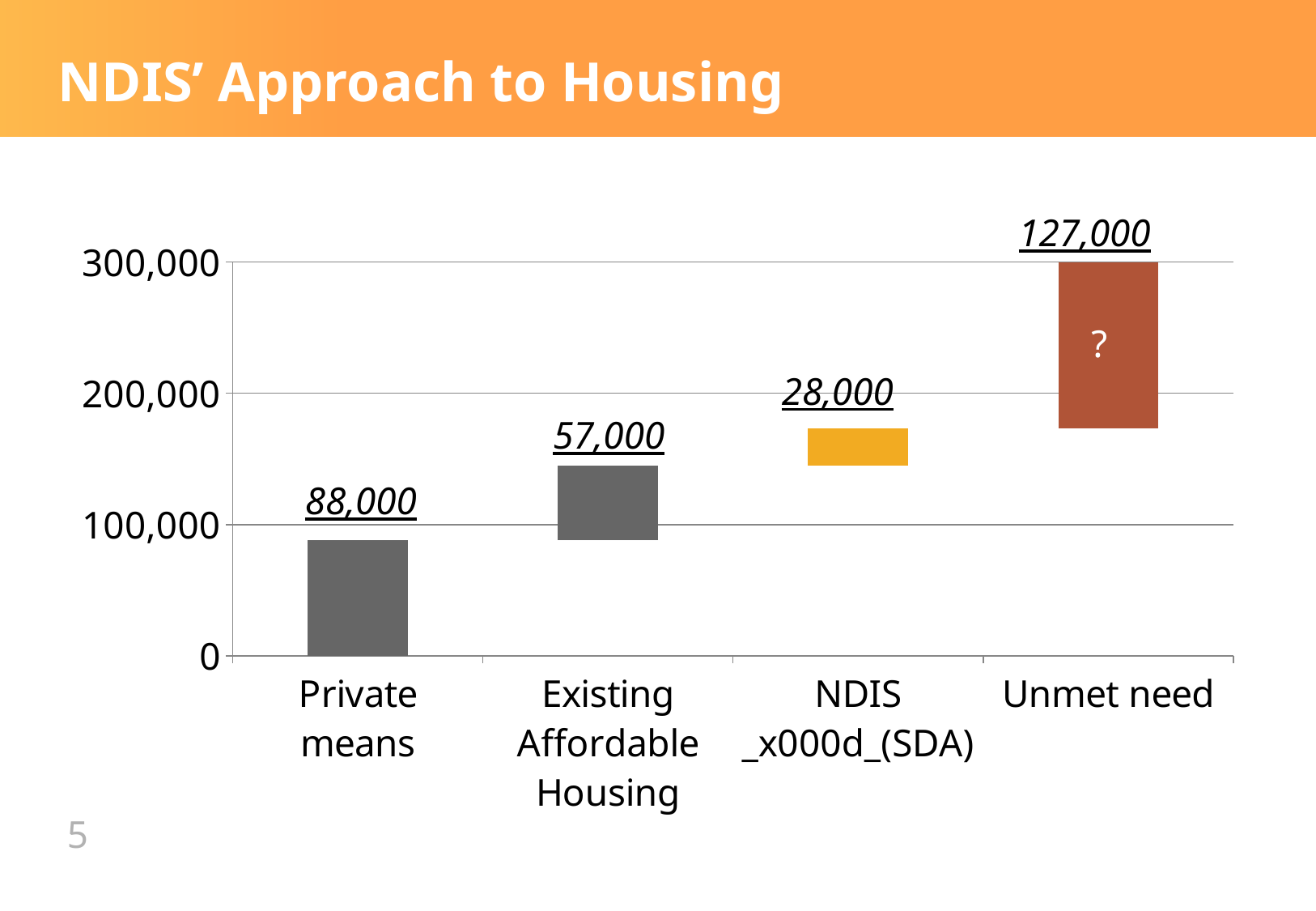
How many categories are shown on the x axis? 4 Which category has the highest value? Unmet need Which category has the lowest value? NDIS (SDA) What is the value shown for Private means? 88,000 What is the value shown for NDIS (SDA)? 28,000 What is the value shown for Unmet need? 127,000 What is the value shown for Existing Affordable Housing? 57,000 Is the top of the Private means bar greater or less than 100,000? less What is the difference between the values for Private means and Existing Affordable Housing? 31,000 Which is larger, the value for Unmet need or the value for Private means? Unmet need What kind of chart is shown on the slide? Bar chart What is the title of the slide containing the chart? NDIS' Approach to Housing